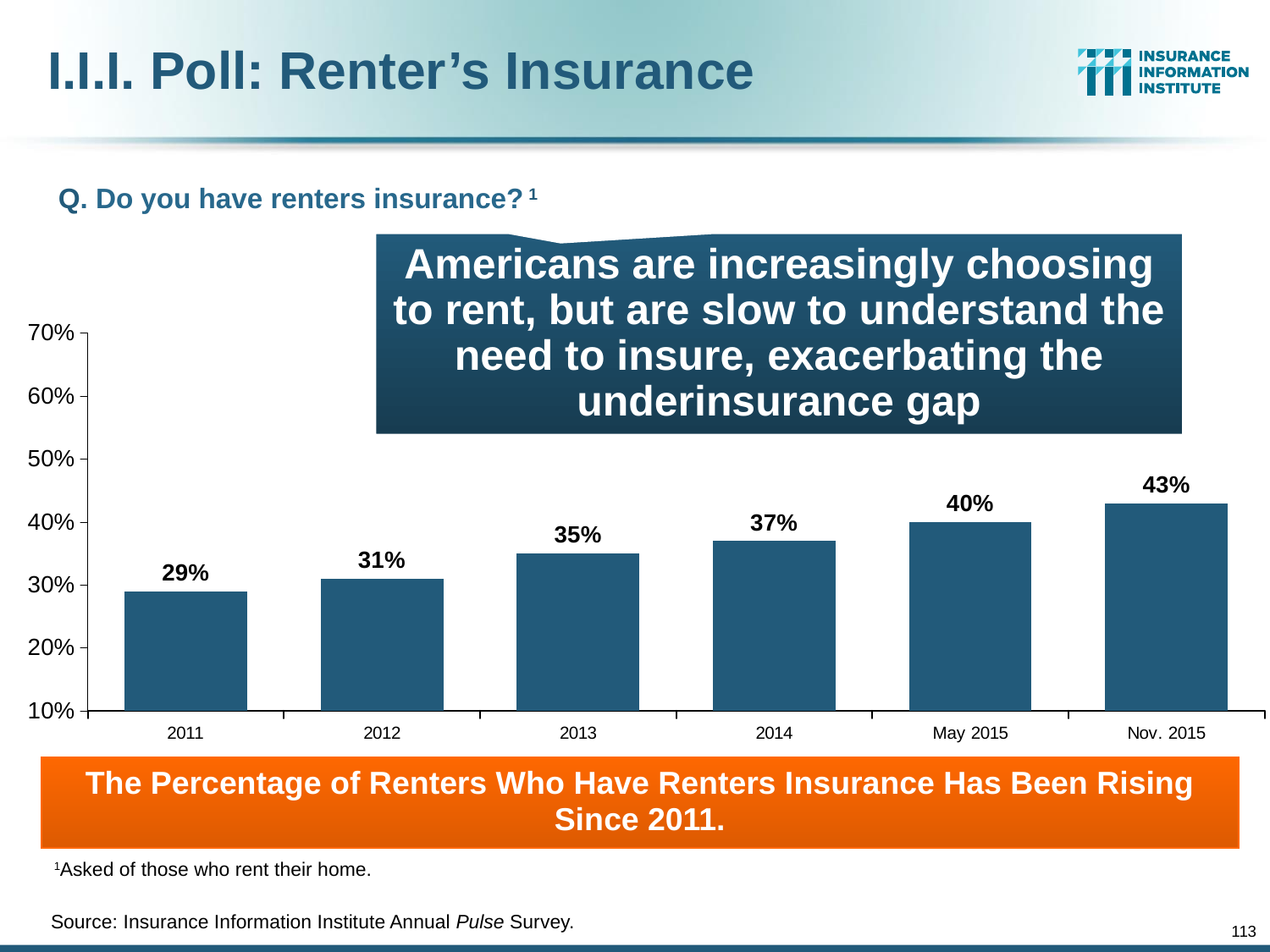
Do the values rise or fall from 2011 to Nov. 2015? Rise Is the value for Nov. 2015 greater or less than 40%? greater What percentage of renters said they have renters insurance in 2011? 29% Which period has the highest percentage of renters with renters insurance? Nov. 2015 What kind of chart is used to show the poll results? Bar chart What is the value shown for 2013? 35% What is the difference between the 2014 value and the 2012 value? 6 percentage points By how many percentage points did the value change from 2011 to Nov. 2015? 14 percentage points How many time periods are shown on the x axis of the chart? 6 Which period has the lowest percentage of renters with renters insurance? 2011 Which is larger, the value for 2013 or the value for May 2015? May 2015 What is the value shown for May 2015? 40%